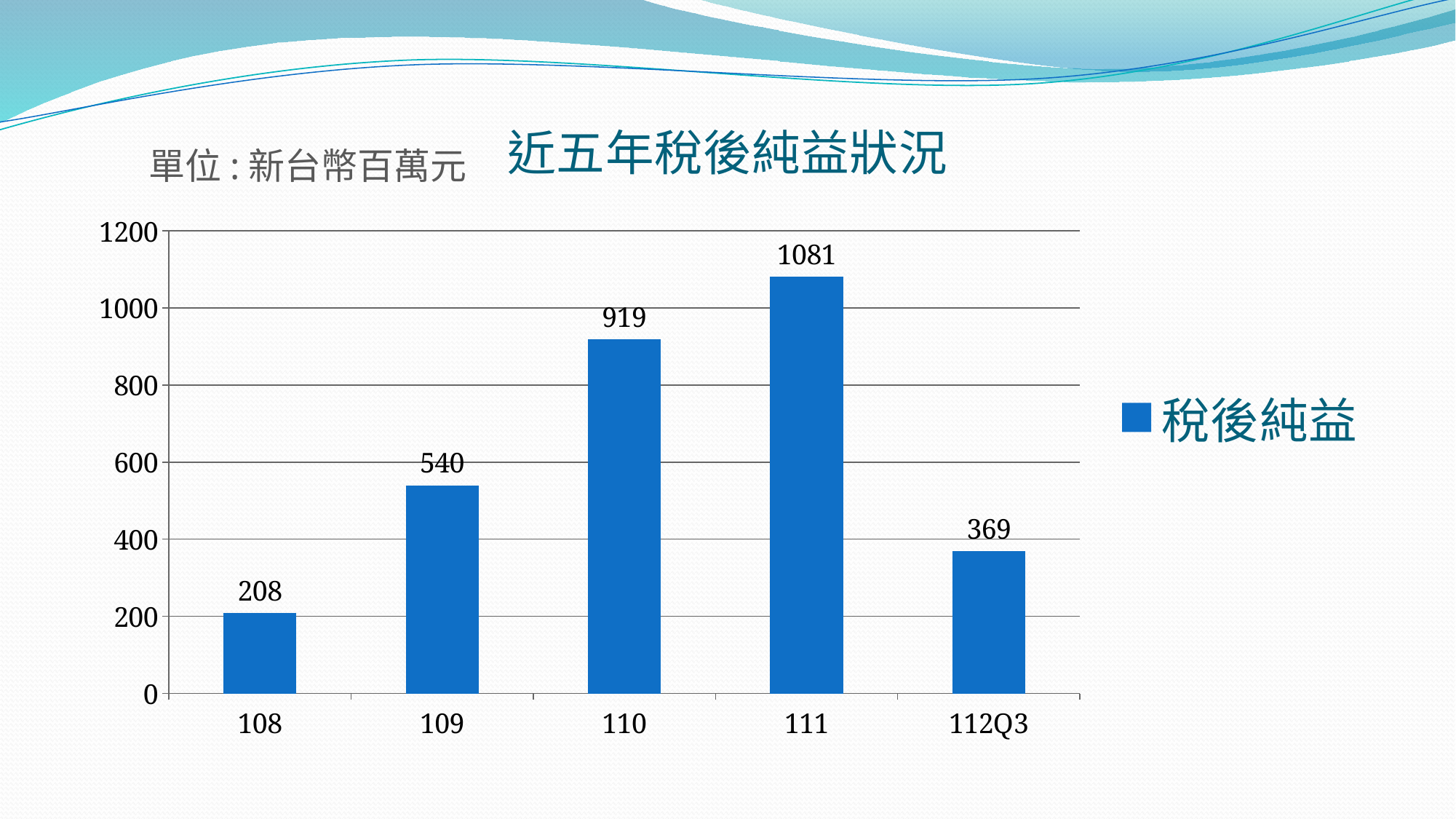
Which is larger, the value for 109 or the value for 112Q3? 109 What is the value for 111? 1081 Which category has the lowest value? 108 How many categories are shown on the x axis? 5 Which category has the highest value? 111 What is the value for 112Q3? 369 What kind of chart is shown on the slide? bar chart Is the value for 110 greater or less than 800? greater What is the title of the chart? 近五年稅後純益狀況 What is the difference between the values for 109 and 108? 332 What is the value for 108? 208 What is the difference between the values for 111 and 110? 162